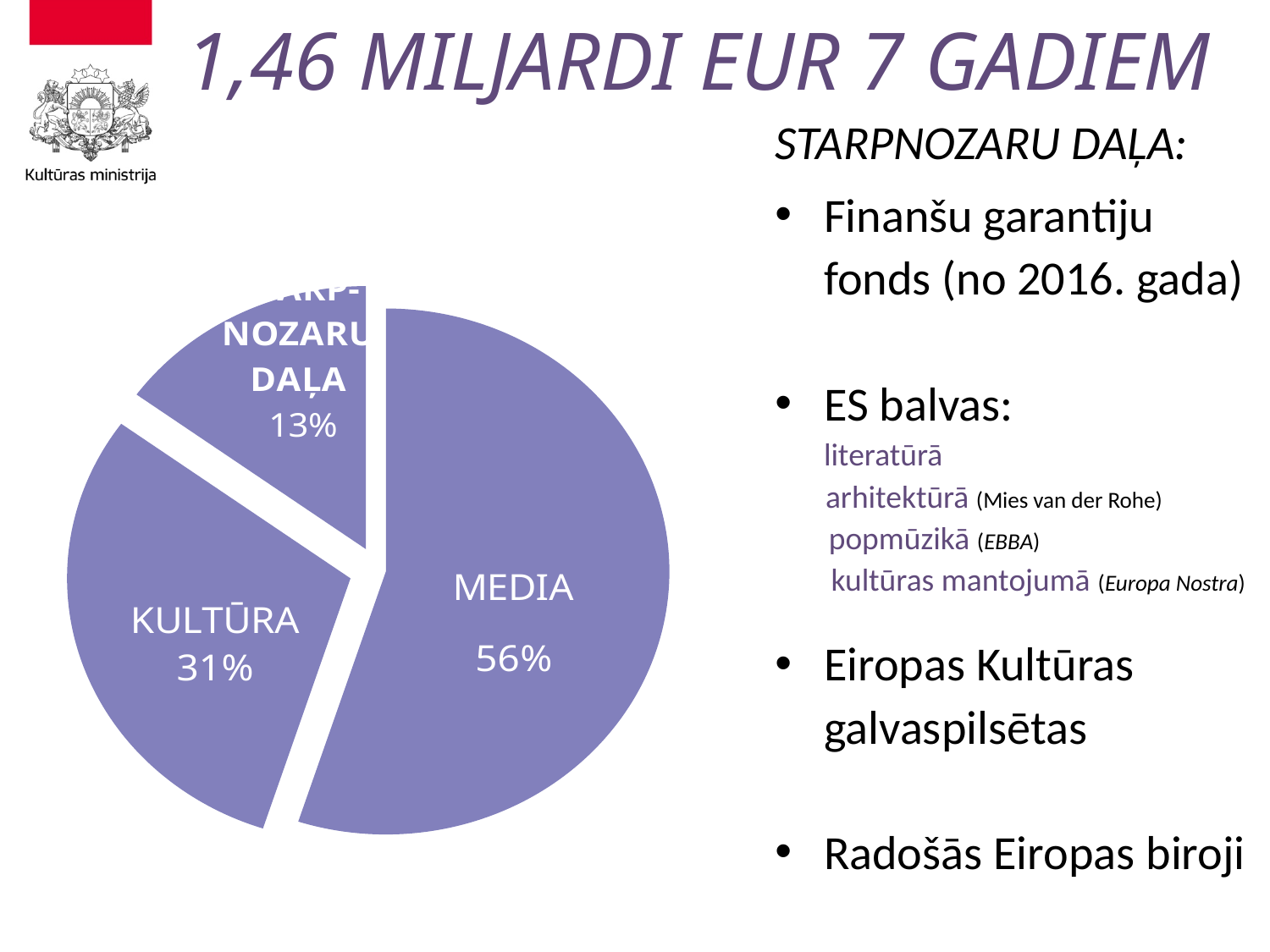
What is the difference in percentage points between the KULTŪRA slice and the STARPNOZARU DAĻA slice? 18 What share of the pie does STARPNOZARU DAĻA hold? 13% Is the MEDIA slice greater or less than 50% of the pie? greater What is the title shown at the top of the slide above the chart? 1,46 MILJARDI EUR 7 GADIEM How many slices does the pie chart have? 3 What share of the pie does KULTŪRA hold? 31% What is the difference in percentage points between the MEDIA slice and the KULTŪRA slice? 25 What type of chart is shown on the slide? pie chart Which slice of the pie chart is the smallest? STARPNOZARU DAĻA Which is larger, the KULTŪRA slice or the STARPNOZARU DAĻA slice? KULTŪRA Which slice of the pie chart is the largest? MEDIA What share of the pie does MEDIA hold? 56%